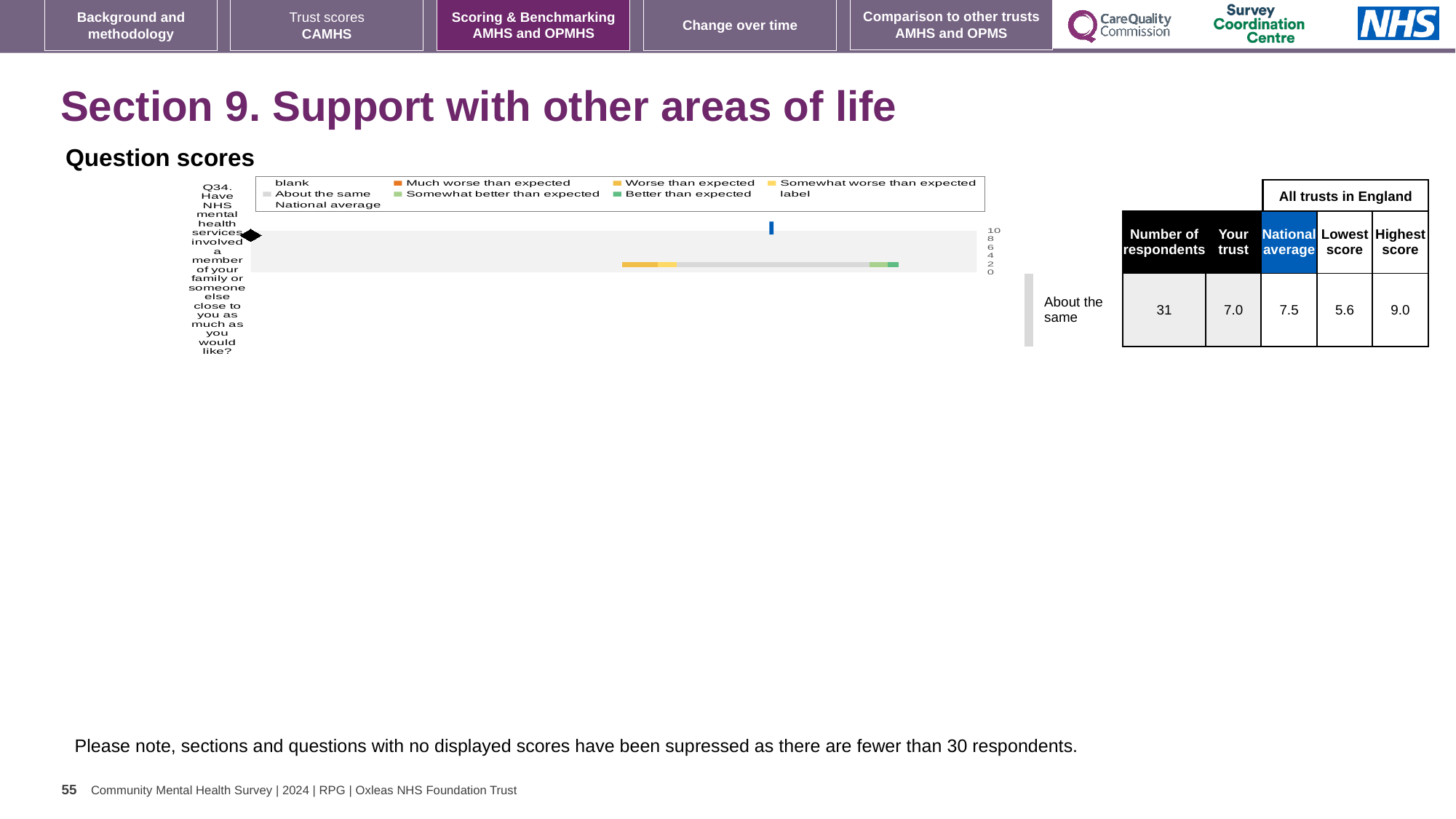
How many respondents answered Q34? 31 Which is larger for Q34, the trust's score or the national average? national average What is the highest score among all trusts in England for Q34? 9.0 What is the trust's score for Q34 as printed on the slide? 7.0 Which question number is shown on the Question scores chart? Q34 What is the national average score for Q34 as printed on the slide? 7.5 What is the lowest score among all trusts in England for Q34? 5.6 What is the maximum value shown on the score axis of the Question scores chart? 10 What is the difference between the highest and lowest scores for Q34 across all trusts in England? 3.4 What kind of chart is used to show the Q34 question score? bar chart Is the national average marker for Q34 greater or less than 6 on the score axis? greater How many questions are plotted in the Question scores chart? 1